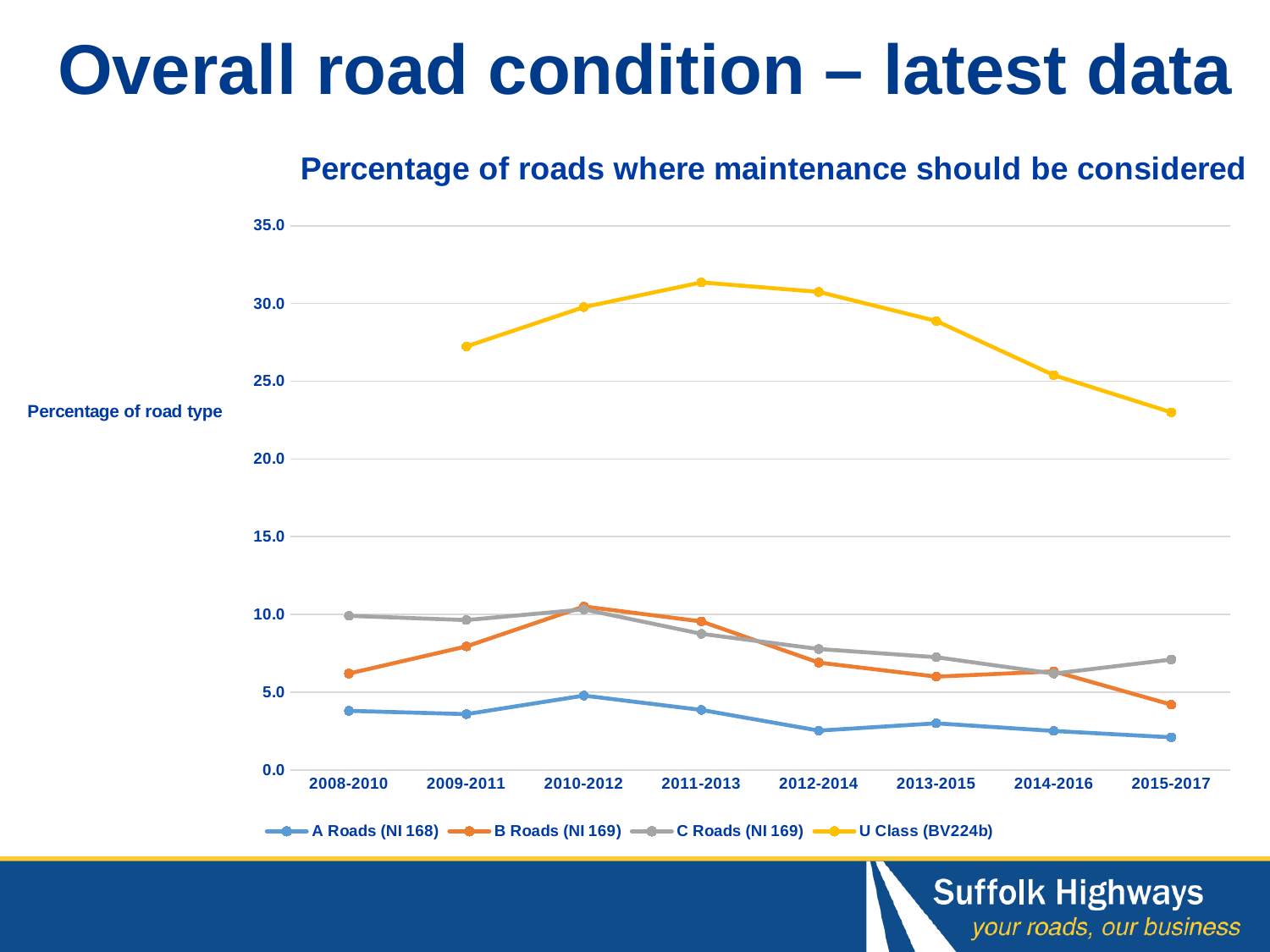
In which period does the U Class (BV224b) line reach its highest value? 2011-2013 Is the value for U Class (BV224b) in 2015-2017 greater or less than 25.0? less What kind of chart is shown on the slide? Line chart How many series does the legend list? 4 In which period does the A Roads (NI 168) line reach its highest value? 2010-2012 In 2015-2017, which is higher: C Roads (NI 169) or B Roads (NI 169)? C Roads (NI 169) In which period does the U Class (BV224b) line reach its lowest value? 2015-2017 Is the value for U Class (BV224b) in 2011-2013 greater or less than 30.0? greater Does the U Class (BV224b) line rise or fall from 2011-2013 to 2015-2017? Fall In which period does the B Roads (NI 169) line reach its lowest value? 2015-2017 How many time periods are shown on the x axis? 8 What is the label on the vertical axis of the chart? Percentage of road type